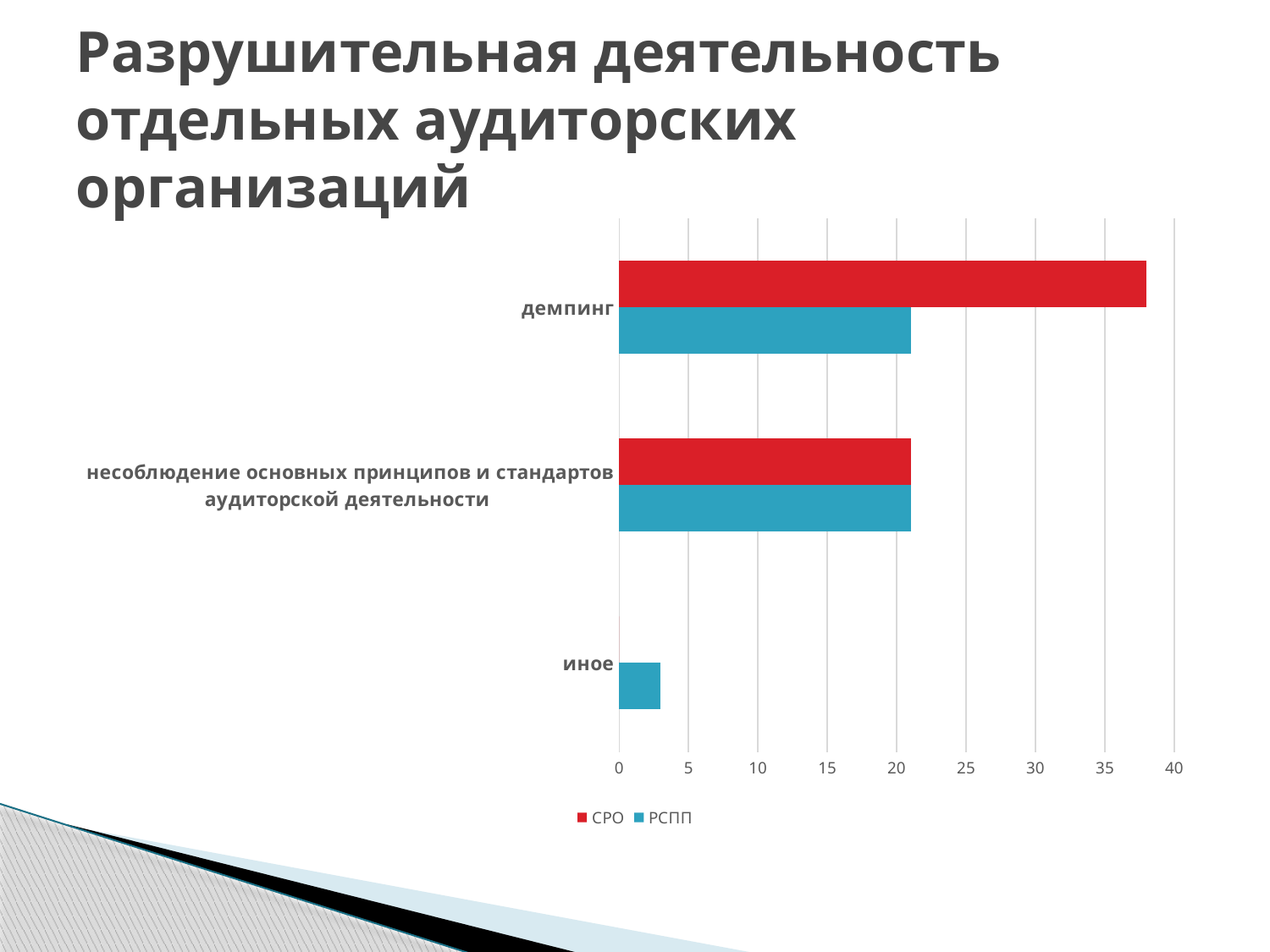
How many categories are shown on the chart? 3 Which series are listed in the legend? СРО and РСПП For the СРО series, which category has the larger value, демпинг or несоблюдение основных принципов и стандартов аудиторской деятельности? демпинг Is the РСПП value for иное greater or less than 5? less What kind of chart is shown on the slide? bar chart Which category has the highest value for the СРО series? демпинг What colour are the bars for the СРО series? red For the category демпинг, which series has the larger value, СРО or РСПП? СРО Is the РСПП value for демпинг greater or less than 25? less Which category has the lowest value for the РСПП series? иное Is the СРО value for демпинг greater or less than 35? greater How many series does the legend list? 2